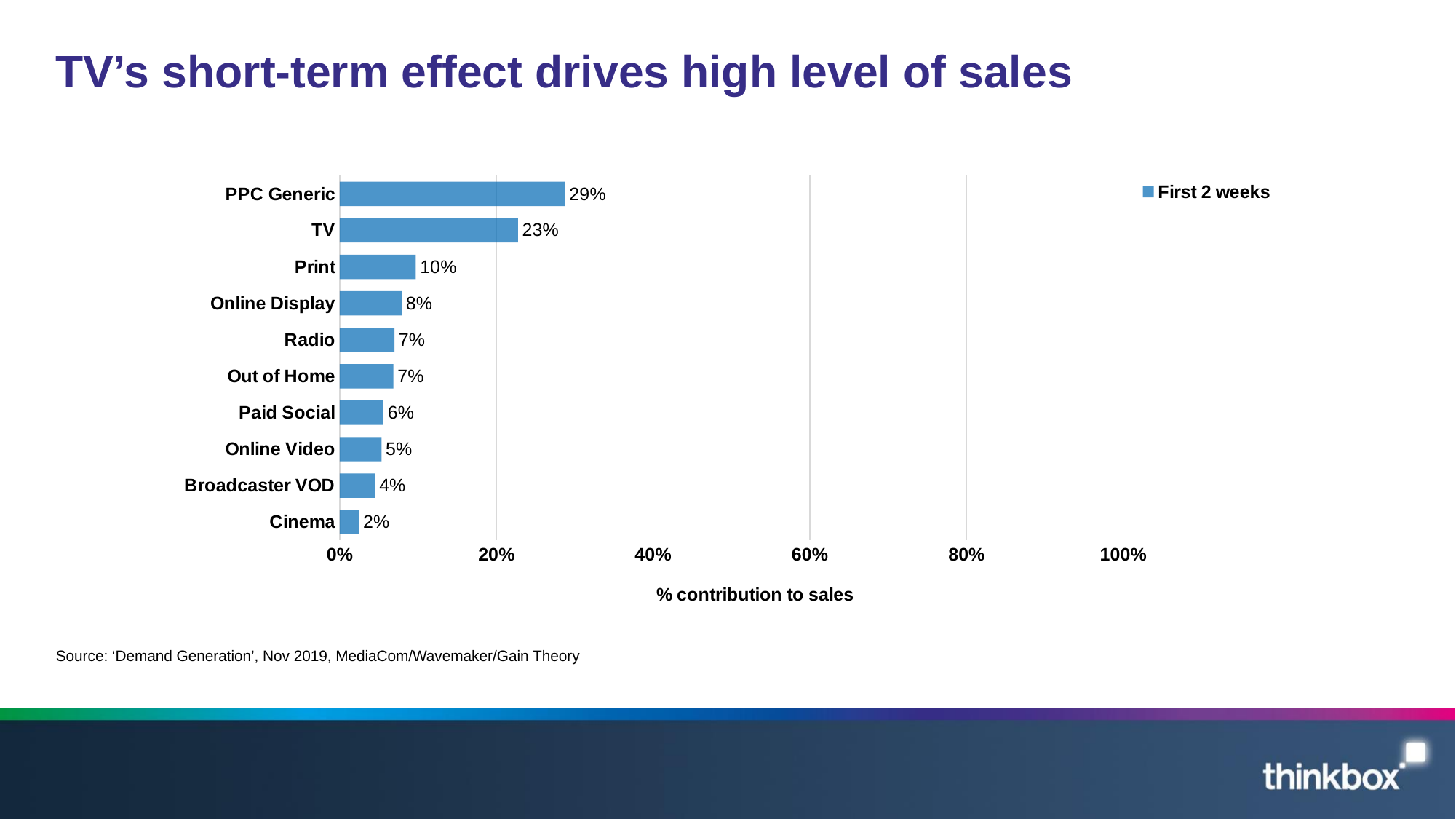
What is the label on the horizontal axis of the chart? % contribution to sales What kind of chart is shown on the slide? Bar chart What is the value for Broadcaster VOD? 4% What is the difference between the values for PPC Generic and TV? 6% Which category has the highest value? PPC Generic What is the difference between the values for Print and Cinema? 8% Which category has the lowest value? Cinema What is the value for TV? 23% Is the value for PPC Generic greater or less than 20%? greater Which is larger, the value for Paid Social or the value for Online Video? Paid Social How many categories are shown on the chart? 10 What is the value for Online Display? 8%